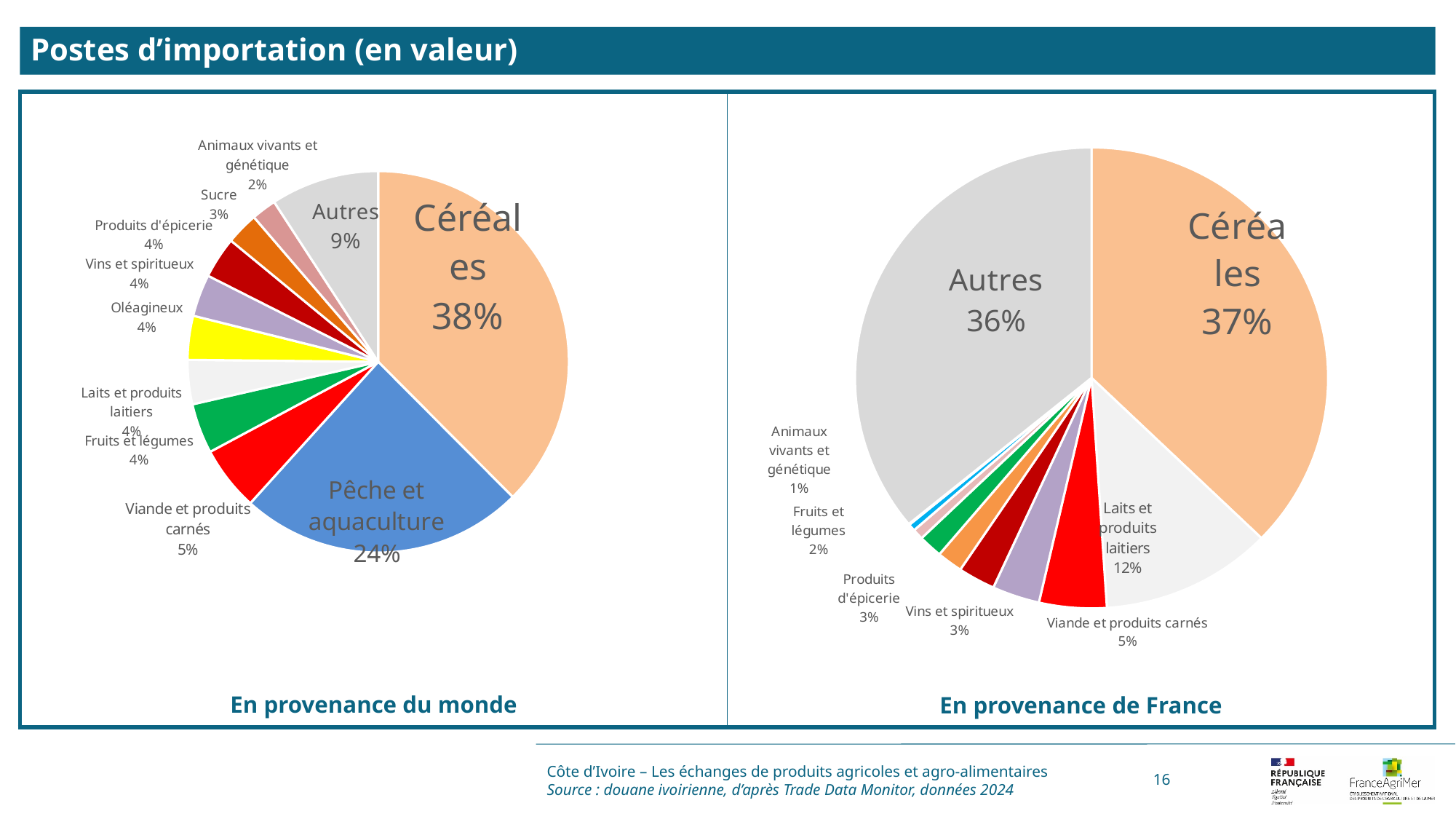
In the 'En provenance du monde' chart, which category has the largest share? Céréales In the 'En provenance de France' chart, which is larger: Laits et produits laitiers or Viande et produits carnés? Laits et produits laitiers What is the title of the slide? Postes d'importation (en valeur) In the 'En provenance du monde' chart, what share does Pêche et aquaculture represent? 24% In the 'En provenance du monde' chart, which category has the smallest share? Animaux vivants et génétique What type of chart is used on this slide? Pie chart How many slices does the 'En provenance du monde' pie chart have? 11 In the 'En provenance du monde' chart, what is the difference in percentage points between Céréales and Pêche et aquaculture? 14 In the 'En provenance de France' chart, what share does Autres represent? 36% In the 'En provenance du monde' chart, what share do Céréales represent? 38% In the 'En provenance de France' chart, what share do Laits et produits laitiers represent? 12%